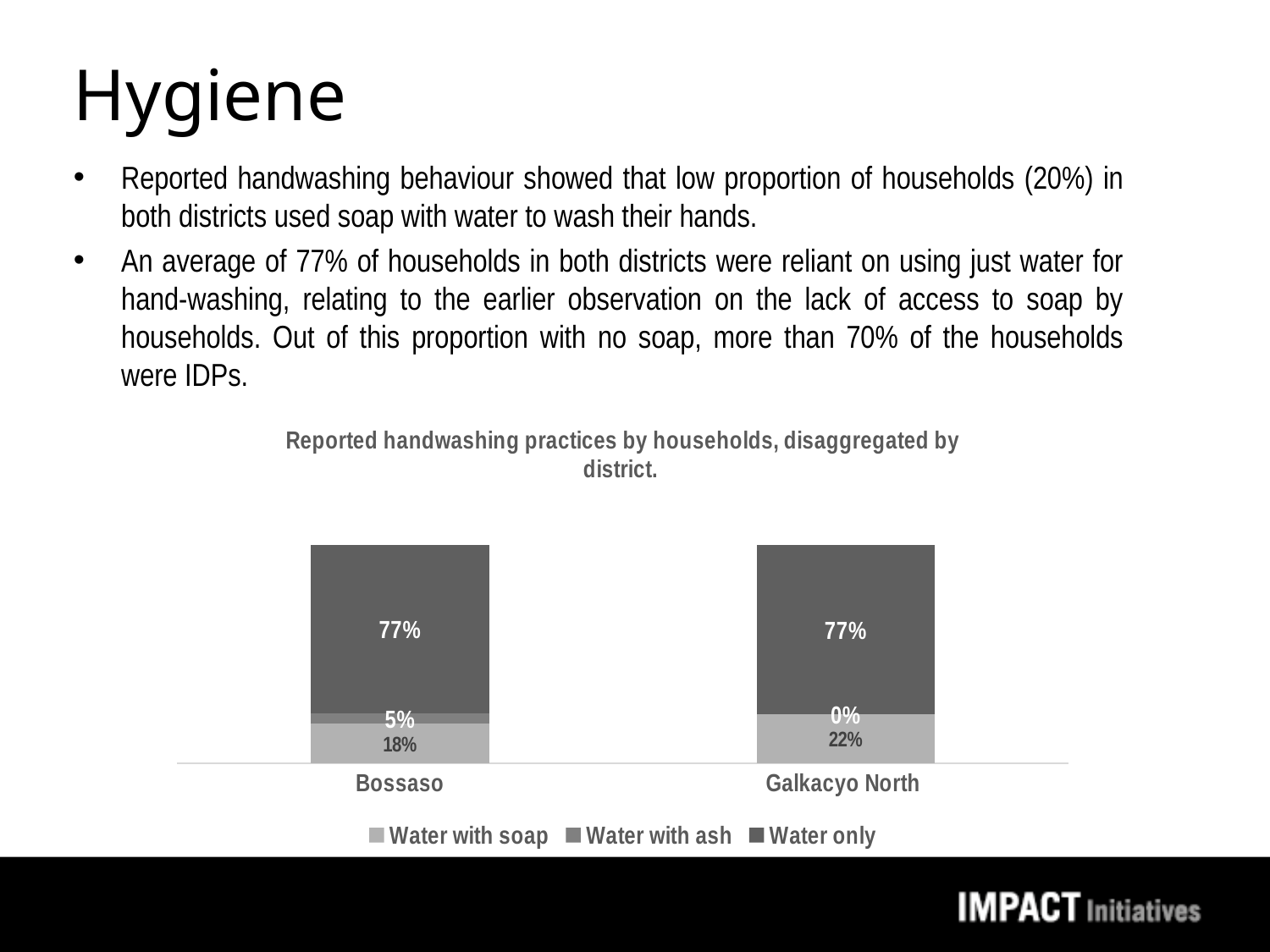
What percentage of households in Bossaso reported washing with water with soap? 18% What is the value for water with ash in Galkacyo North? 0% What percentage of households in Galkacyo North reported washing with water with soap? 22% How many districts are shown on the x axis of the chart? 2 What is the title of the chart? Reported handwashing practices by households, disaggregated by district. Which district has the higher value for water with soap, Bossaso or Galkacyo North? Galkacyo North What type of chart is shown on the slide? Stacked bar chart What is the value for water only in Galkacyo North? 77% What is the value for water with ash in Bossaso? 5% What is the difference between the water with soap values for Galkacyo North and Bossaso? 4% How many series does the chart legend list? 3 Which handwashing practice has the highest value in Bossaso? Water only